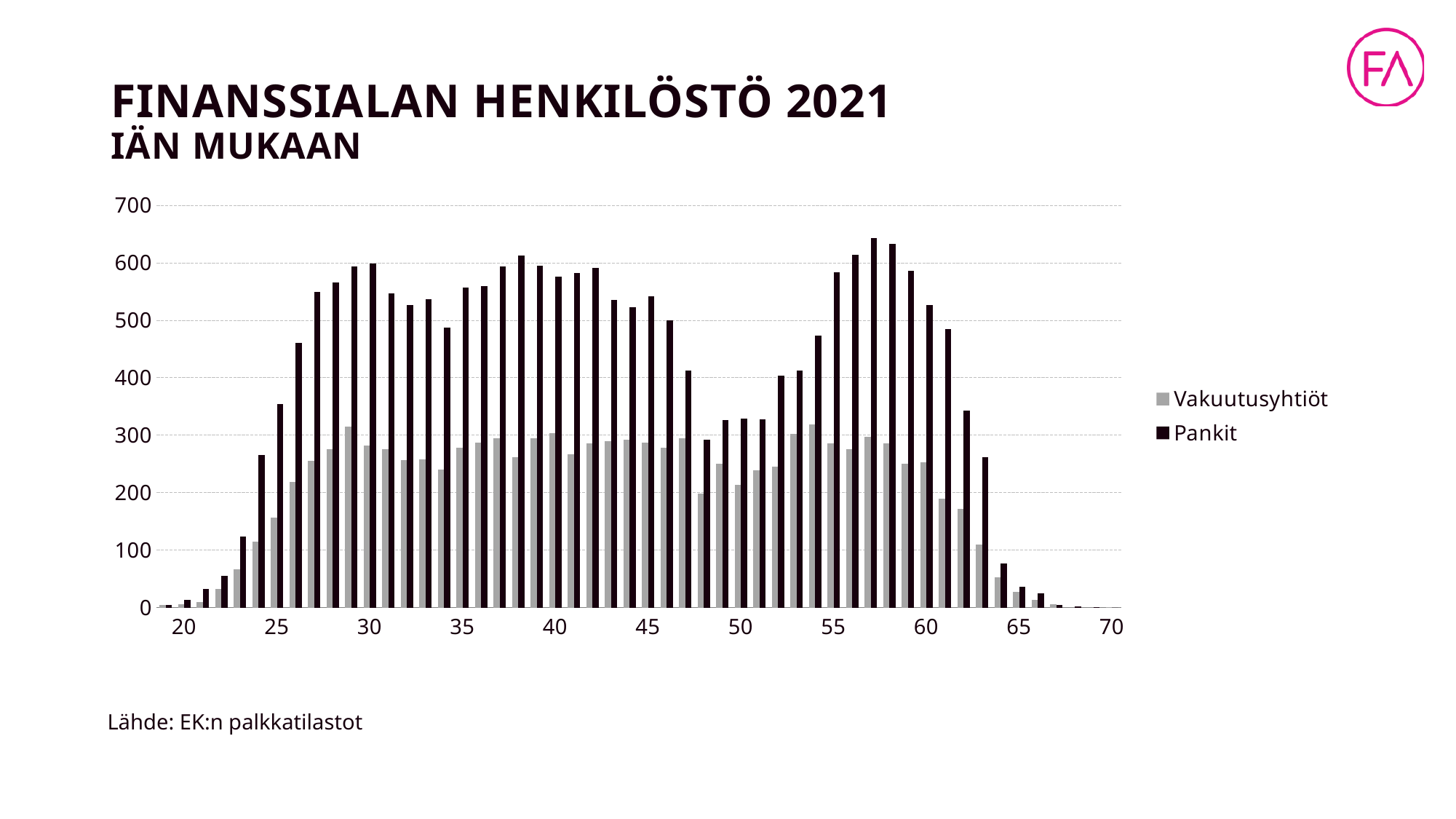
Is the Vakuutusyhtiöt value at age 64 greater or less than 100? less How many series does the legend list? 2 Is the Pankit value at age 57 greater or less than 600? greater Is the Pankit value at age 34 greater or less than 500? less At age 40, which series has the larger value, Vakuutusyhtiöt or Pankit? Pankit Do the Pankit values rise or fall from age 63 to age 70? Fall What is the source given below the chart? EK:n palkkatilastot What kind of chart is shown on the slide? Bar chart What are the two series named in the legend? Vakuutusyhtiöt and Pankit